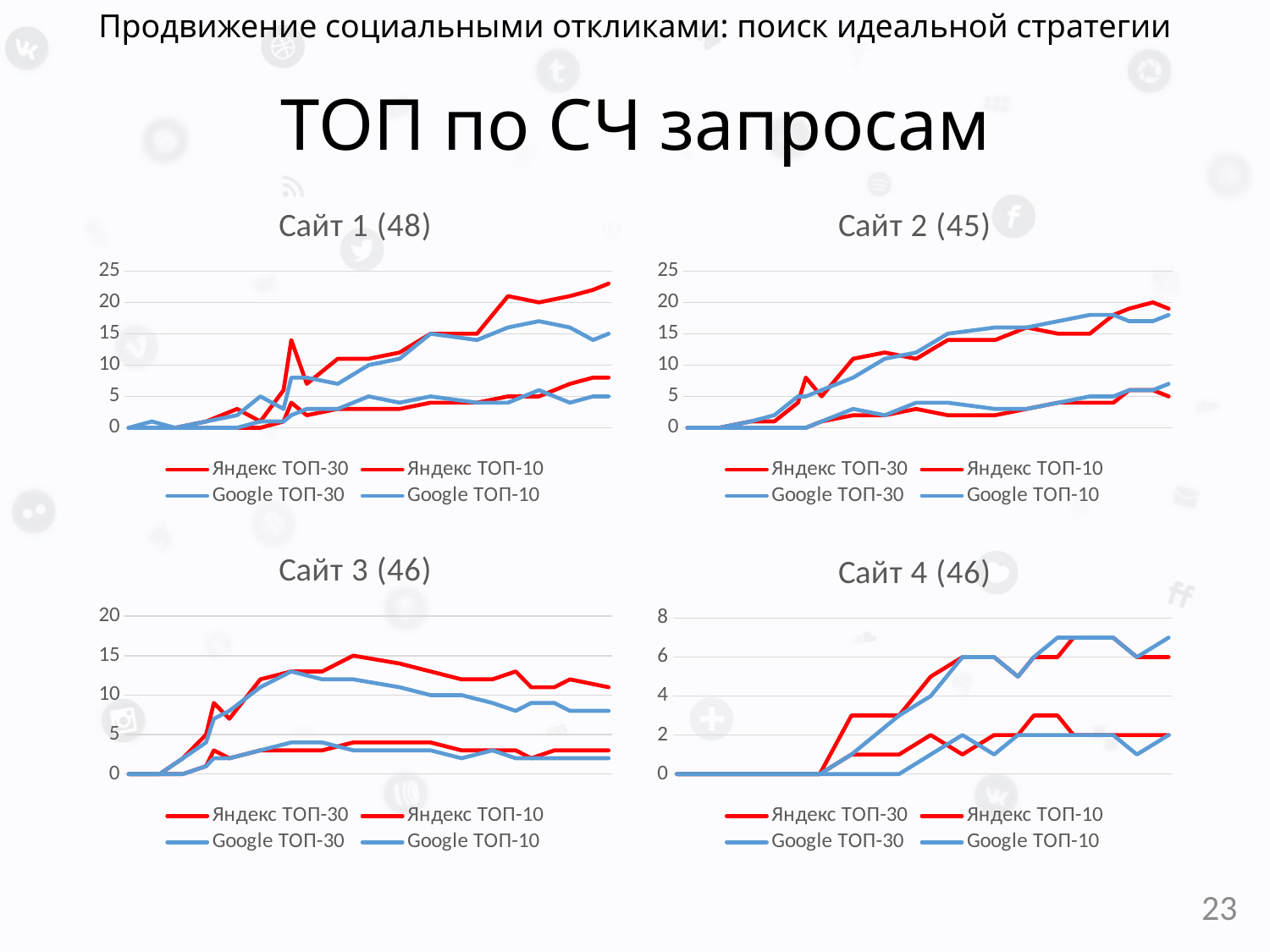
In the chart 'Сайт 4 (46)', is the final value of Google ТОП-30 greater or less than 4? greater How many charts are shown on the slide? 4 In the chart 'Сайт 1 (48)', at the last point, which is larger: Яндекс ТОП-30 or Google ТОП-30? Яндекс ТОП-30 In the chart 'Сайт 1 (48)', is the final value of Яндекс ТОП-30 greater or less than 20? greater In the chart 'Сайт 3 (46)', is the peak value of Яндекс ТОП-30 greater or less than 10? greater What is the highest value shown on the y axis of the chart 'Сайт 4 (46)'? 8 How many series does the legend of 'Сайт 2 (45)' list? 4 What kind of chart is 'Сайт 1 (48)'? Line chart In the chart 'Сайт 2 (45)', does the Яндекс ТОП-30 line rise or fall along the x axis? rise What are the titles of the four charts on the slide? Сайт 1 (48), Сайт 2 (45), Сайт 3 (46), Сайт 4 (46) In the chart 'Сайт 1 (48)', which series reaches the highest value? Яндекс ТОП-30